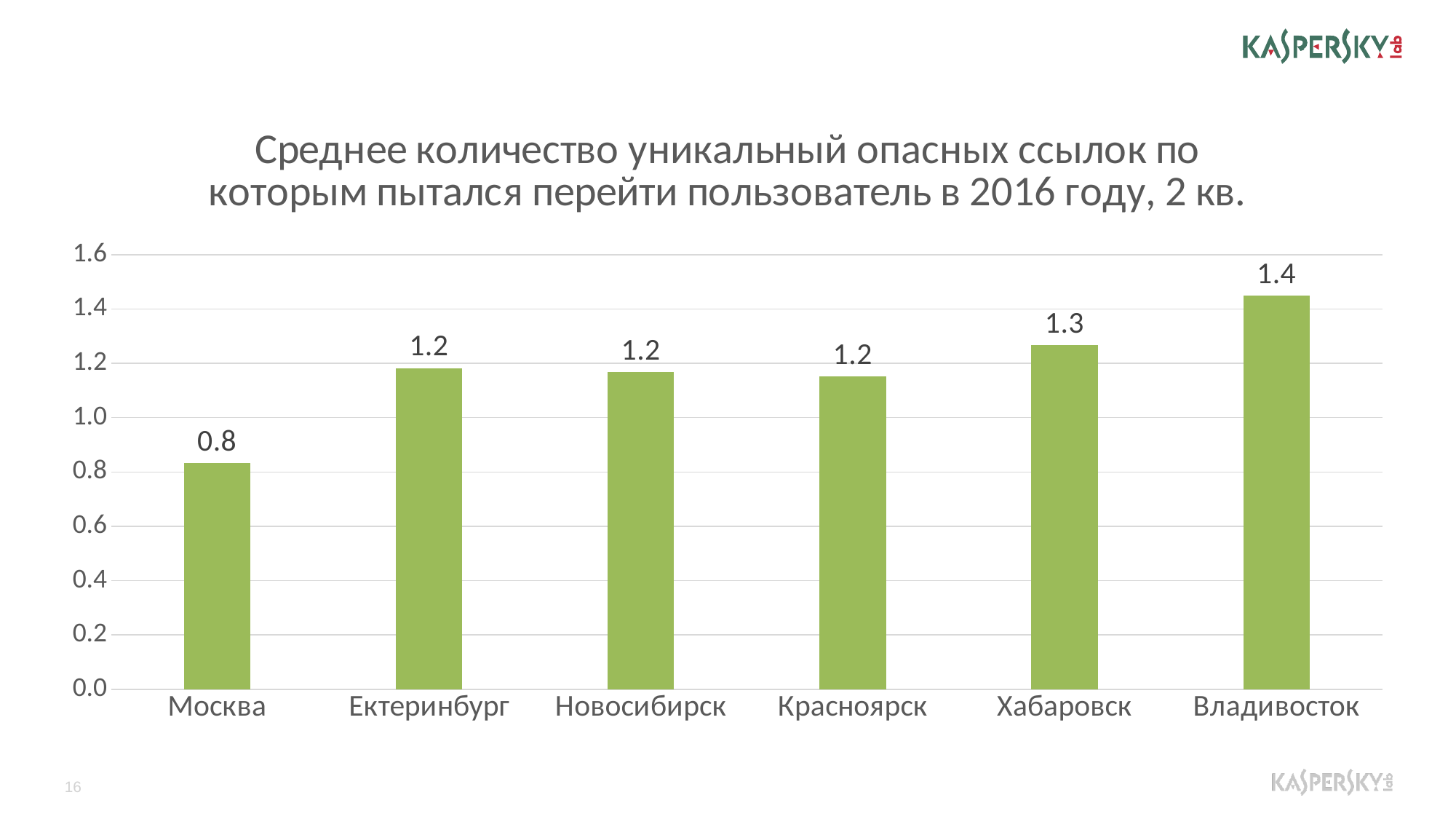
What is the value for Хабаровск? 1.3 Which city has the lowest value? Москва Is the value for Москва greater or less than 1.0? less How many cities are shown on the chart? 6 What is the value for Новосибирск? 1.2 What is the title of the chart? Среднее количество уникальный опасных ссылок по которым пытался перейти пользователь в 2016 году, 2 кв. What kind of chart is shown on the slide? bar chart Which is larger, the value for Хабаровск or the value for Москва? Хабаровск What is the value for Москва? 0.8 What is the value for Владивосток? 1.4 What is the difference between the values for Владивосток and Москва? 0.6 Which city has the highest value? Владивосток